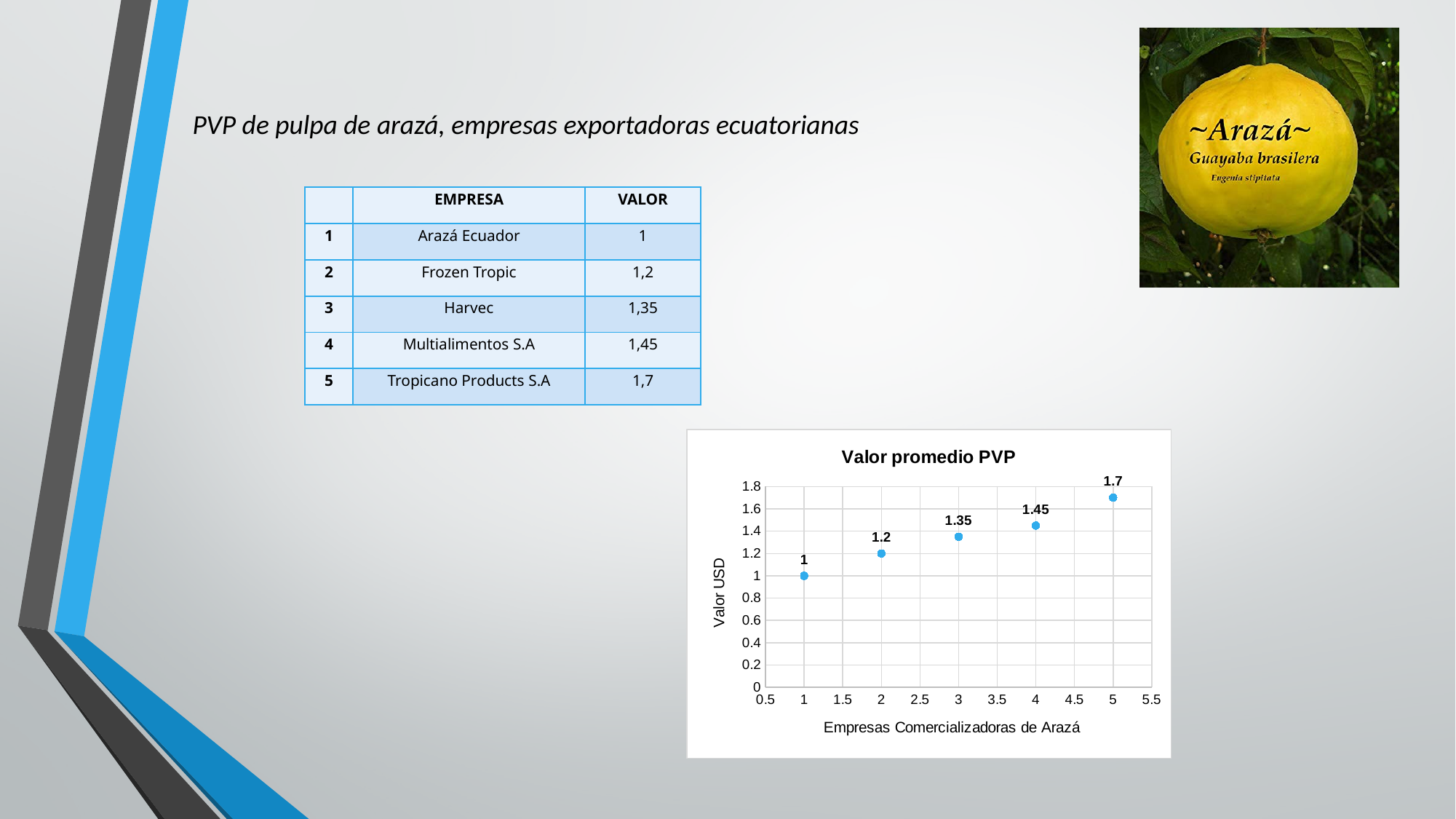
What is the y-axis title of the chart? Valor USD Which is larger in the chart, the value at x = 2 or the value at x = 4? x = 4 Which x position has the highest value in the chart? 5 What is the value of the point at x = 5 in the chart? 1.7 What is the difference between the values at x = 5 and x = 1 in the chart? 0.7 What is the value of the point at x = 1 in the chart? 1 Do the values in the chart rise or fall as x increases? rise Which x position has the lowest value in the chart? 1 What type of chart is shown on the slide? scatter chart How many data points are plotted in the chart? 5 What is the value of the point at x = 3 in the chart? 1.35 What is the title of the chart? Valor promedio PVP